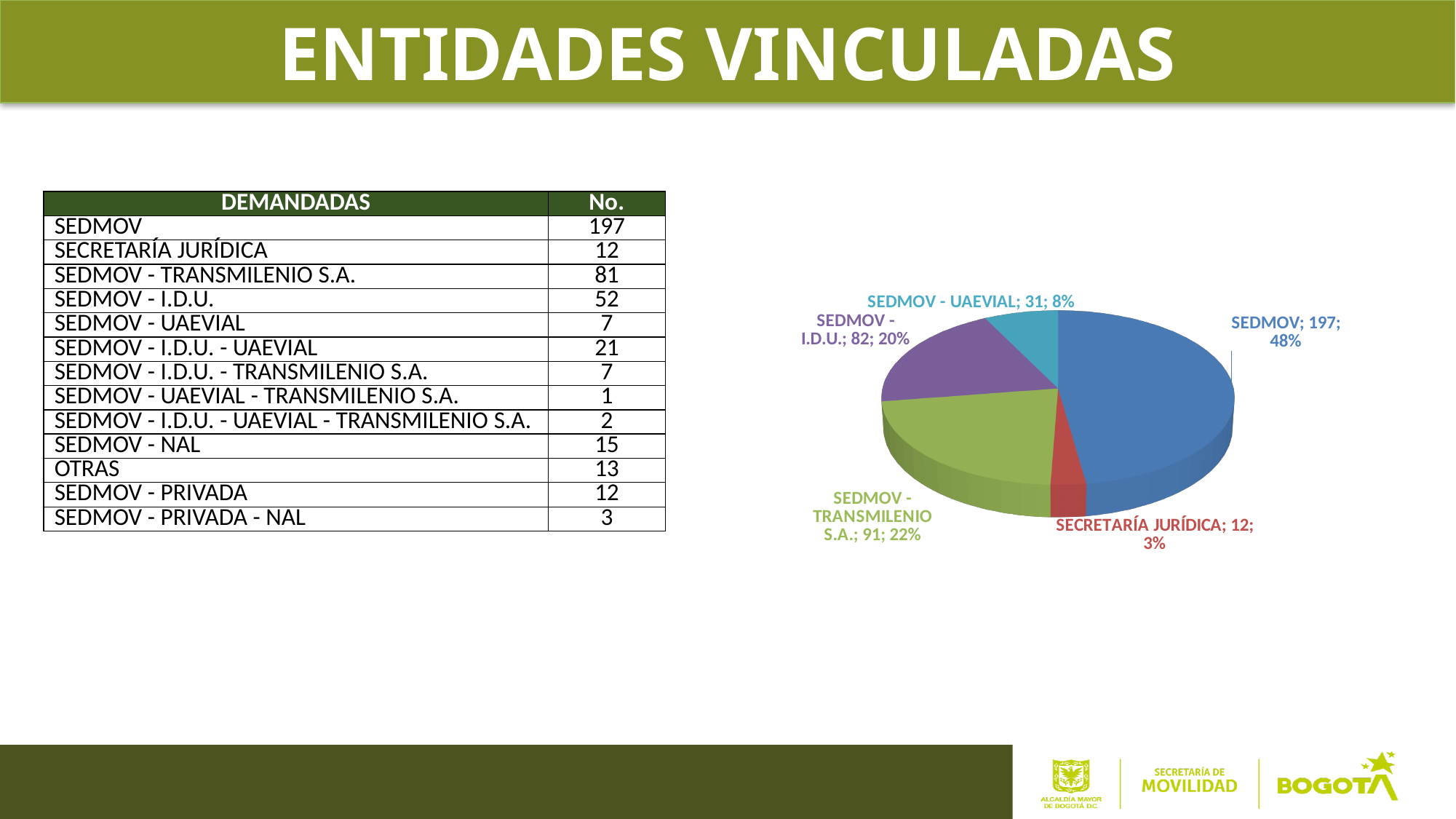
Which slice of the pie chart is the largest? SEDMOV In the pie chart, what is the value for SEDMOV? 197 In the pie chart, what is the value for SEDMOV - UAEVIAL? 31 What share of the pie chart does SECRETARÍA JURÍDICA represent? 3% What kind of chart is shown on the slide? Pie chart How many slices does the pie chart have? 5 Which slice of the pie chart is the smallest? SECRETARÍA JURÍDICA What share of the pie chart does SEDMOV represent? 48% In the pie chart, what is the value for SEDMOV - I.D.U.? 82 In the pie chart, what is the difference between the values for SEDMOV - TRANSMILENIO S.A. and SEDMOV - I.D.U.? 9 In the pie chart, which is larger: SEDMOV - UAEVIAL or SECRETARÍA JURÍDICA? SEDMOV - UAEVIAL In the pie chart, what is the value for SEDMOV - TRANSMILENIO S.A.? 91